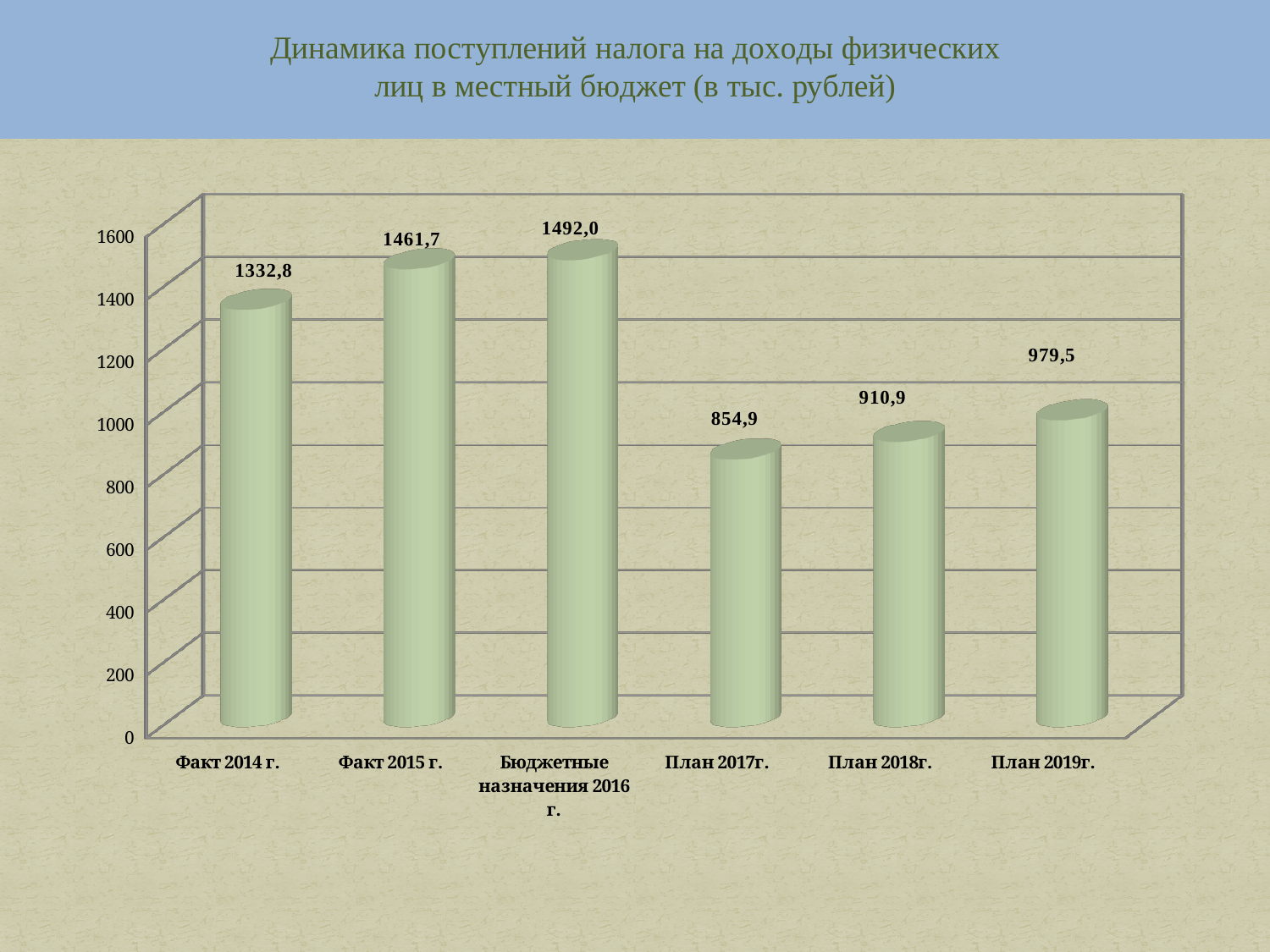
What is the value for План 2018г.? 910,9 Is the value for План 2017г. greater or less than 1000? less What is the difference between the values for План 2019г. and План 2017г.? 124,6 Which category has the lowest value? План 2017г. What kind of chart is shown on the slide? bar chart Which is larger, the value for План 2018г. or the value for План 2019г.? План 2019г. How many categories are shown on the x axis? 6 Which category has the highest value? Бюджетные назначения 2016 г. Do the values rise or fall from План 2017г. to План 2019г.? rise What is the difference between the values for Факт 2015 г. and Факт 2014 г.? 128,9 What is the value for Бюджетные назначения 2016 г.? 1492,0 What is the value for Факт 2014 г.? 1332,8